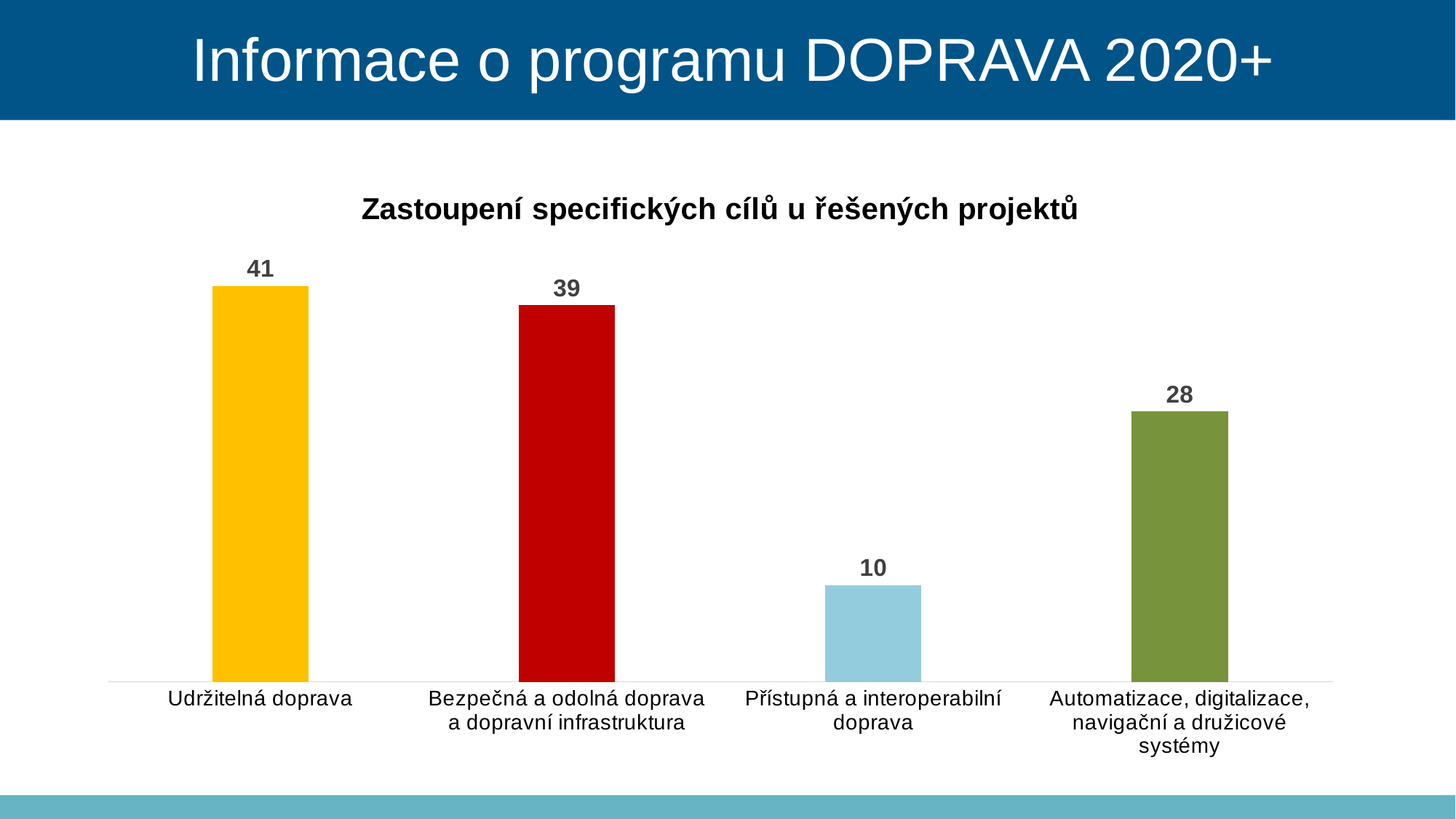
What is the difference between the values for Bezpečná a odolná doprava a dopravní infrastruktura and Automatizace, digitalizace, navigační a družicové systémy? 11 Which category has the highest value? Udržitelná doprava What is the value for Udržitelná doprava? 41 What is the value for Automatizace, digitalizace, navigační a družicové systémy? 28 What is the value for Bezpečná a odolná doprava a dopravní infrastruktura? 39 What is the value for Přístupná a interoperabilní doprava? 10 What is the difference between the values for Udržitelná doprava and Přístupná a interoperabilní doprava? 31 Which category has the lowest value? Přístupná a interoperabilní doprava Which is larger: the value for Automatizace, digitalizace, navigační a družicové systémy or the value for Přístupná a interoperabilní doprava? Automatizace, digitalizace, navigační a družicové systémy What is the title of the chart? Zastoupení specifických cílů u řešených projektů What kind of chart is shown on the slide? Bar chart How many categories are shown in the chart? 4